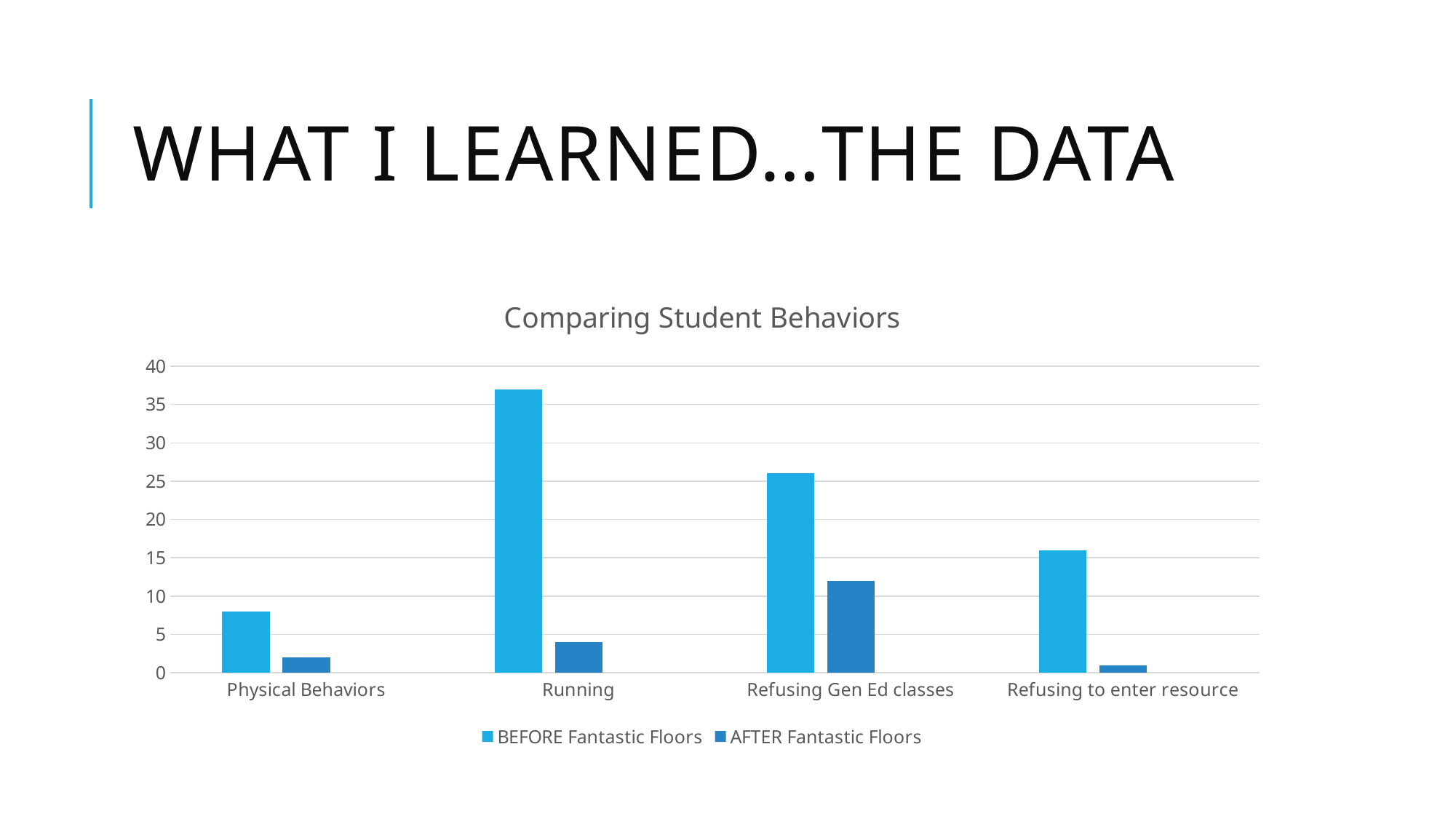
Is the BEFORE Fantastic Floors value for Physical Behaviors greater or less than 10? less How many series does the legend list? 2 Is the BEFORE Fantastic Floors value for Running greater or less than 35? greater Is the AFTER Fantastic Floors value for Refusing Gen Ed classes greater or less than 10? greater Which series is shown in the darker blue colour? AFTER Fantastic Floors Which category has the highest BEFORE Fantastic Floors value? Running For Refusing to enter resource, which is larger: the BEFORE Fantastic Floors value or the AFTER Fantastic Floors value? BEFORE Fantastic Floors Which category has the highest AFTER Fantastic Floors value? Refusing Gen Ed classes How many behavior categories are shown on the x axis? 4 Which category has the lowest AFTER Fantastic Floors value? Refusing to enter resource What type of chart is shown on the slide? bar chart What is the title of the chart? Comparing Student Behaviors